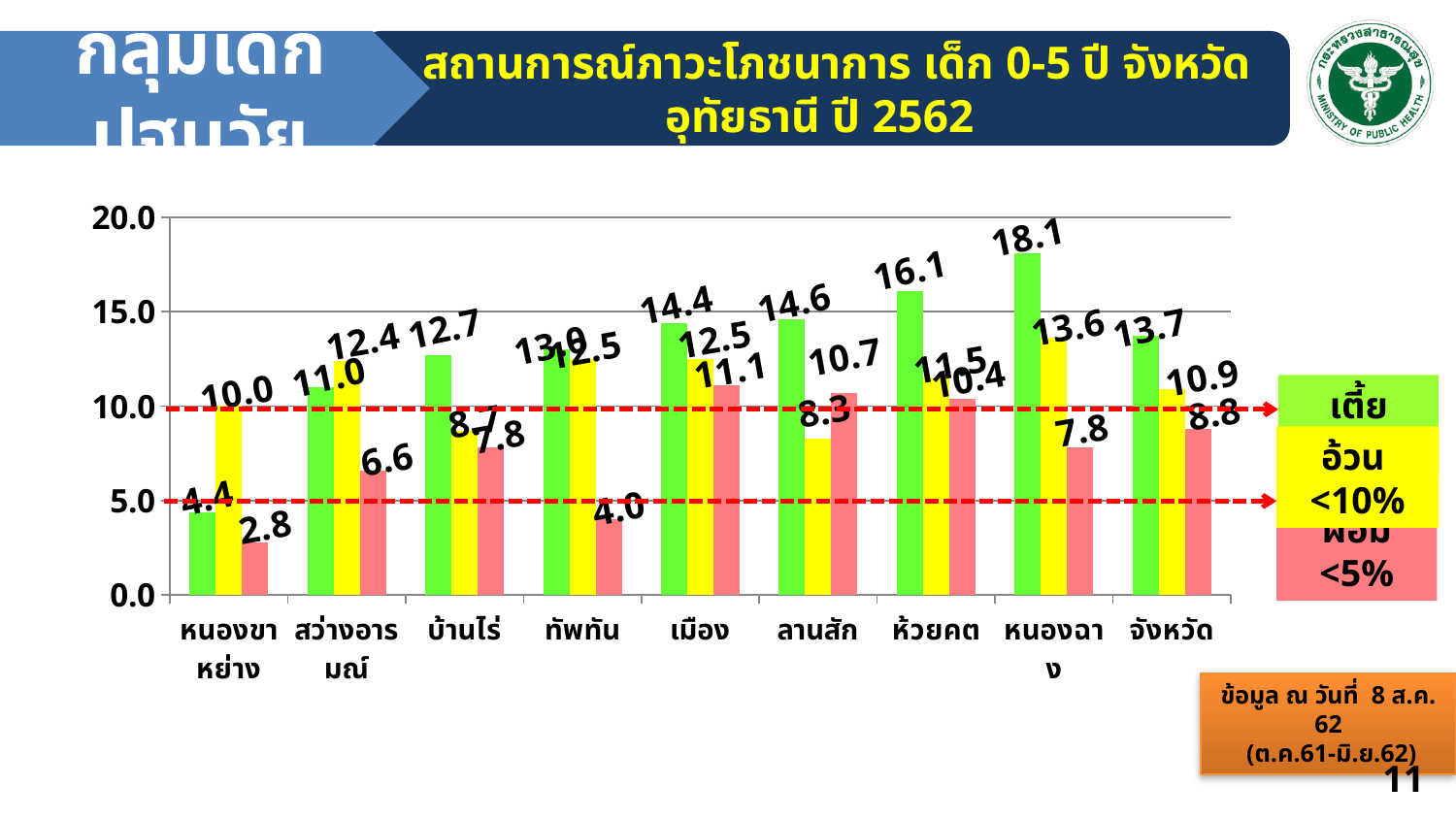
Which is larger: the yellow (อ้วน) value for สว่างอารมณ์ or the yellow (อ้วน) value for จังหวัด? สว่างอารมณ์ What is the value of the yellow (อ้วน) bar for จังหวัด? 10.9 What is the difference between the green (เตี้ย) values for หนองฉาง and ห้วยคต? 2.0 Which category has the highest green (เตี้ย) bar? หนองฉาง What is the value of the pink (ผอม) bar for ลานสัก? 10.7 At which axis value is the upper red dashed horizontal line drawn? 10.0 What is the value of the pink (ผอม) bar for เมือง? 11.1 Which category has the lowest pink (ผอม) bar? หนองขาหย่าง What is the value of the green (เตี้ย) bar for หนองฉาง? 18.1 How many series does the legend on the right of the chart list? 3 What kind of chart is shown on the slide? bar chart How many categories are shown along the x axis of the chart? 9